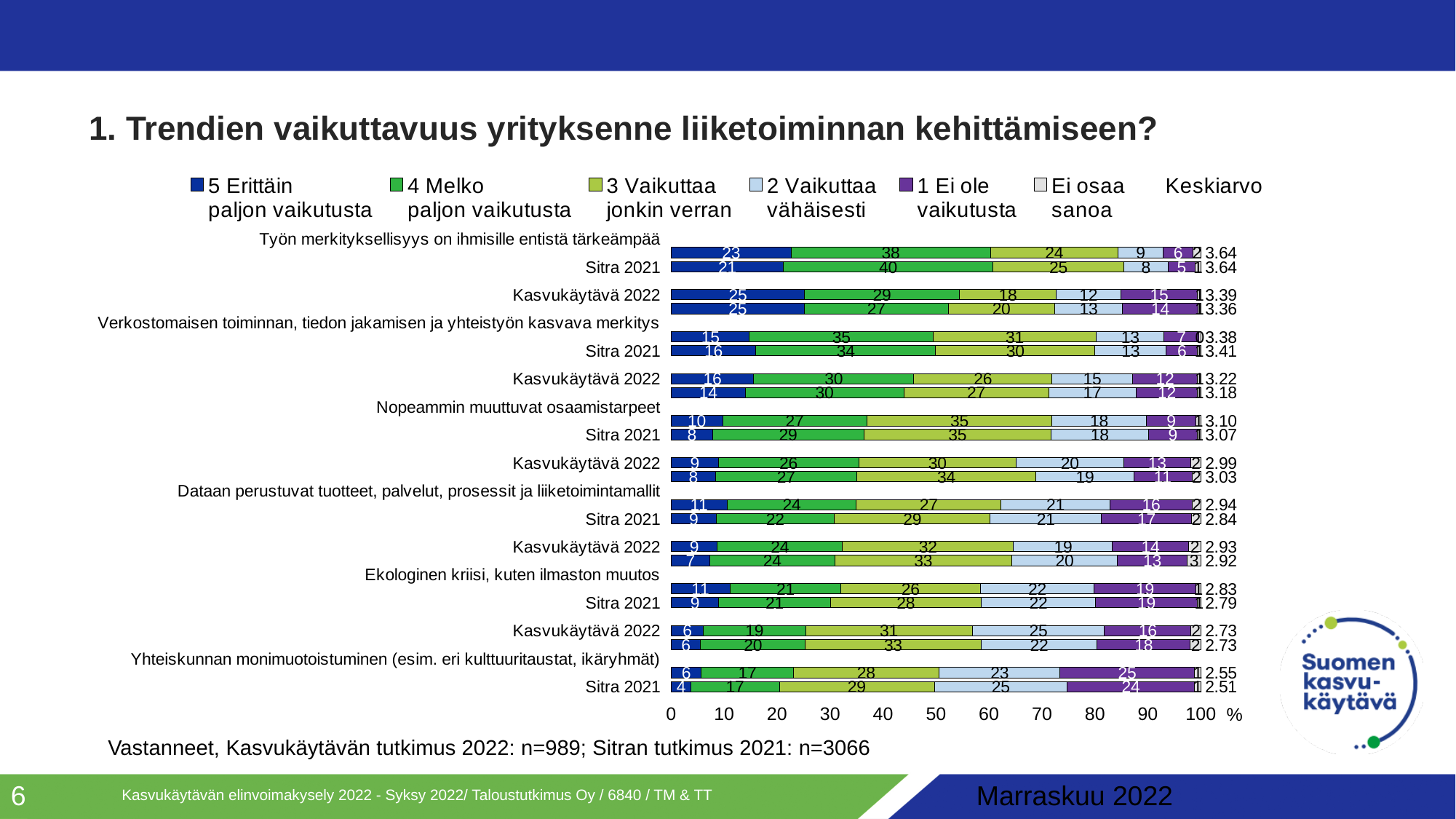
In the topmost bar (Työn merkityksellisyys, Kasvukäytävä 2022), what value is shown for '5 Erittäin paljon vaikutusta'? 23 What is the Keskiarvo value shown for the topmost bar (Työn merkityksellisyys on ihmisille entistä tärkeämpää, Kasvukäytävä 2022)? 3.64 What is the highest Keskiarvo value shown on the chart? 3.64 How many entries does the chart legend list? 7 In the topmost bar (Työn merkityksellisyys, Kasvukäytävä 2022), what value is shown for '4 Melko paljon vaikutusta'? 38 What is the lowest Keskiarvo value shown on the chart? 2.51 In the bottom bar (Sitra 2021, Yhteiskunnan monimuotoistuminen), what value is shown for '1 Ei ole vaikutusta'? 24 In the topmost bar, how much larger is the '4 Melko paljon vaikutusta' value than the '5 Erittäin paljon vaikutusta' value? 15 What is the maximum value shown on the horizontal axis of the chart? 100 % What is the Keskiarvo value shown for the bottom bar (Sitra 2021, Yhteiskunnan monimuotoistuminen)? 2.51 What kind of chart is shown on the slide? bar chart In the topmost bar, which segment is larger: '4 Melko paljon vaikutusta' or '3 Vaikuttaa jonkin verran'? 4 Melko paljon vaikutusta